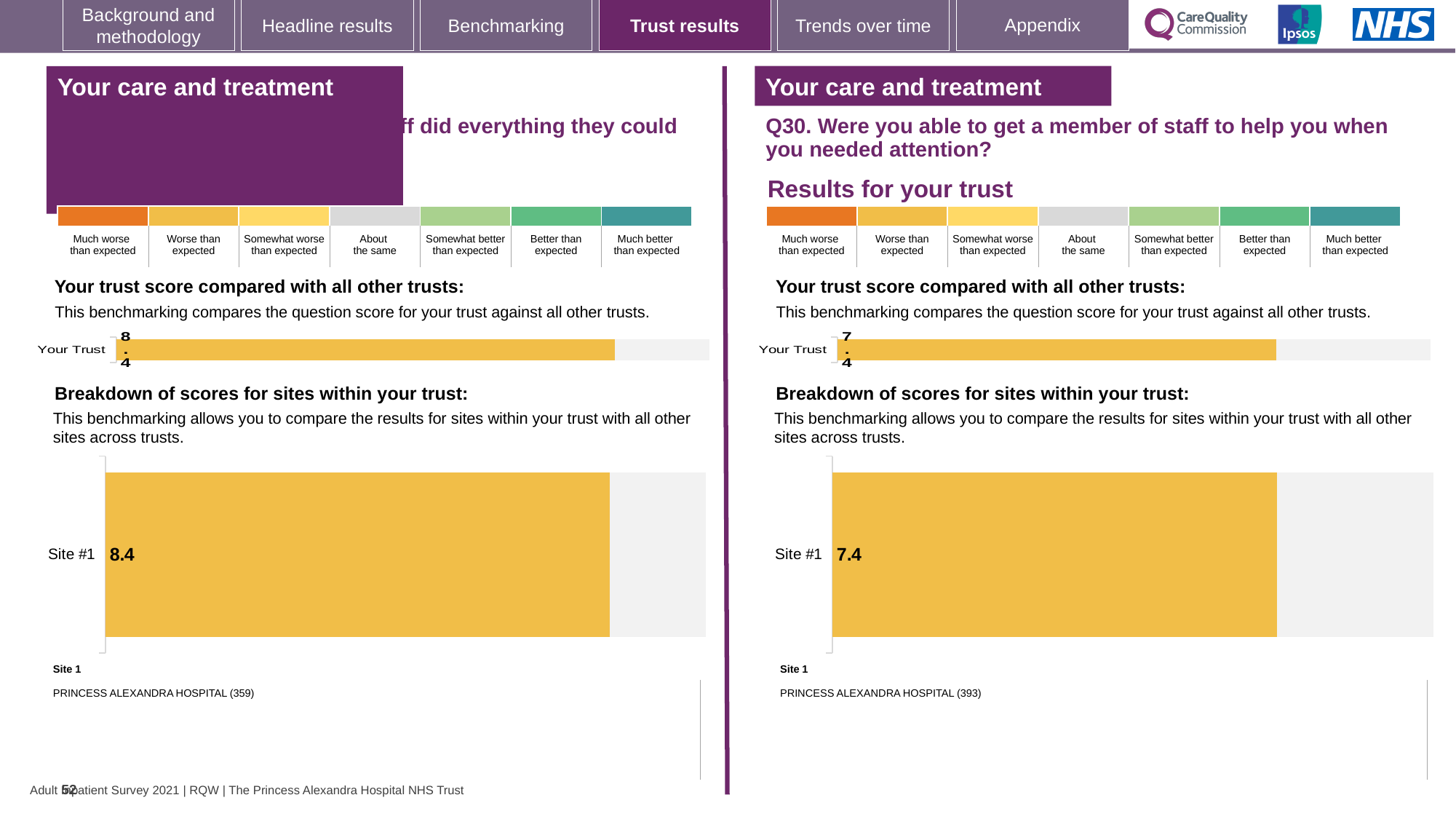
On the left-hand 'Your trust score compared with all other trusts' chart, what is the score for Your Trust? 8.4 Which site name is listed under Site 1 on the right-hand (Q30) side of the slide? PRINCESS ALEXANDRA HOSPITAL (393) What kind of chart is used to show the Site #1 score on the right-hand (Q30) side of the slide? Bar chart How many sites are shown in the right-hand (Q30) 'Breakdown of scores for sites within your trust' chart? 1 What colour is the bar for Site #1 on the right-hand (Q30) chart? Yellow How many sites are shown in the left-hand 'Breakdown of scores for sites within your trust' chart? 1 On the right-hand (Q30) 'Breakdown of scores for sites within your trust' chart, what is the score for Site #1? 7.4 On the right-hand (Q30) 'Your trust score compared with all other trusts' chart, what is the score for Your Trust? 7.4 On the left-hand 'Breakdown of scores for sites within your trust' chart, what is the score for Site #1? 8.4 Which is larger: the Your Trust score on the left-hand chart or the Your Trust score on the right-hand (Q30) chart? The left-hand chart (8.4) What is the difference between the Site #1 score on the left-hand chart and the Site #1 score on the right-hand (Q30) chart? 1.0